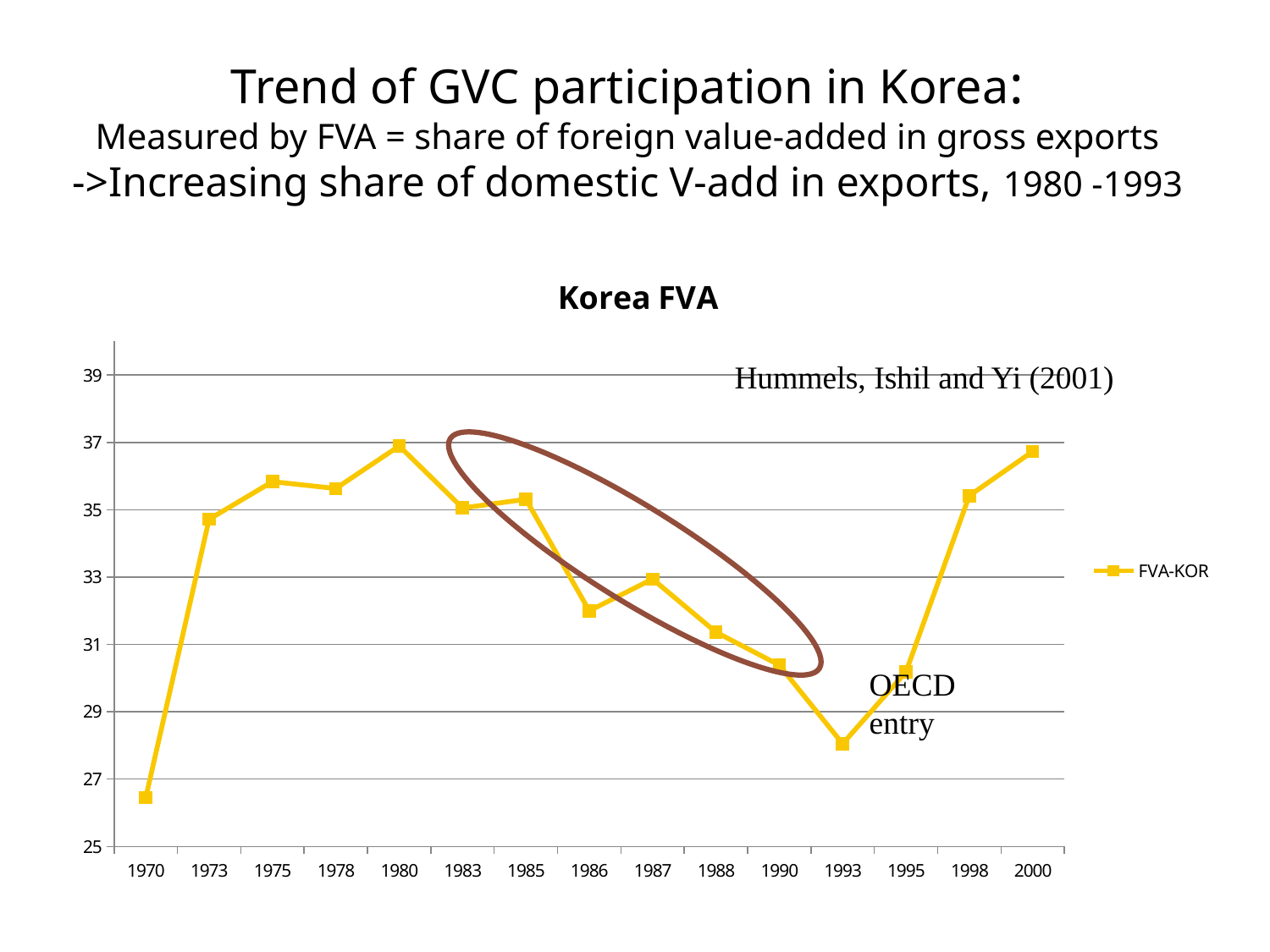
What is the name of the series shown in the legend? FVA-KOR Which year has the lowest FVA-KOR value? 1970 Is the value for 1970 greater or less than 27? less Is the value for 1975 greater or less than 35? greater What kind of chart is shown on the slide? line chart Is the value for 1986 greater or less than 33? less How many series does the legend list? 1 How many years are plotted on the x axis? 15 What is the title of the chart? Korea FVA Do the values rise or fall between 1980 and 1993? fall Which is larger, the value for 1985 or the value for 1986? 1985